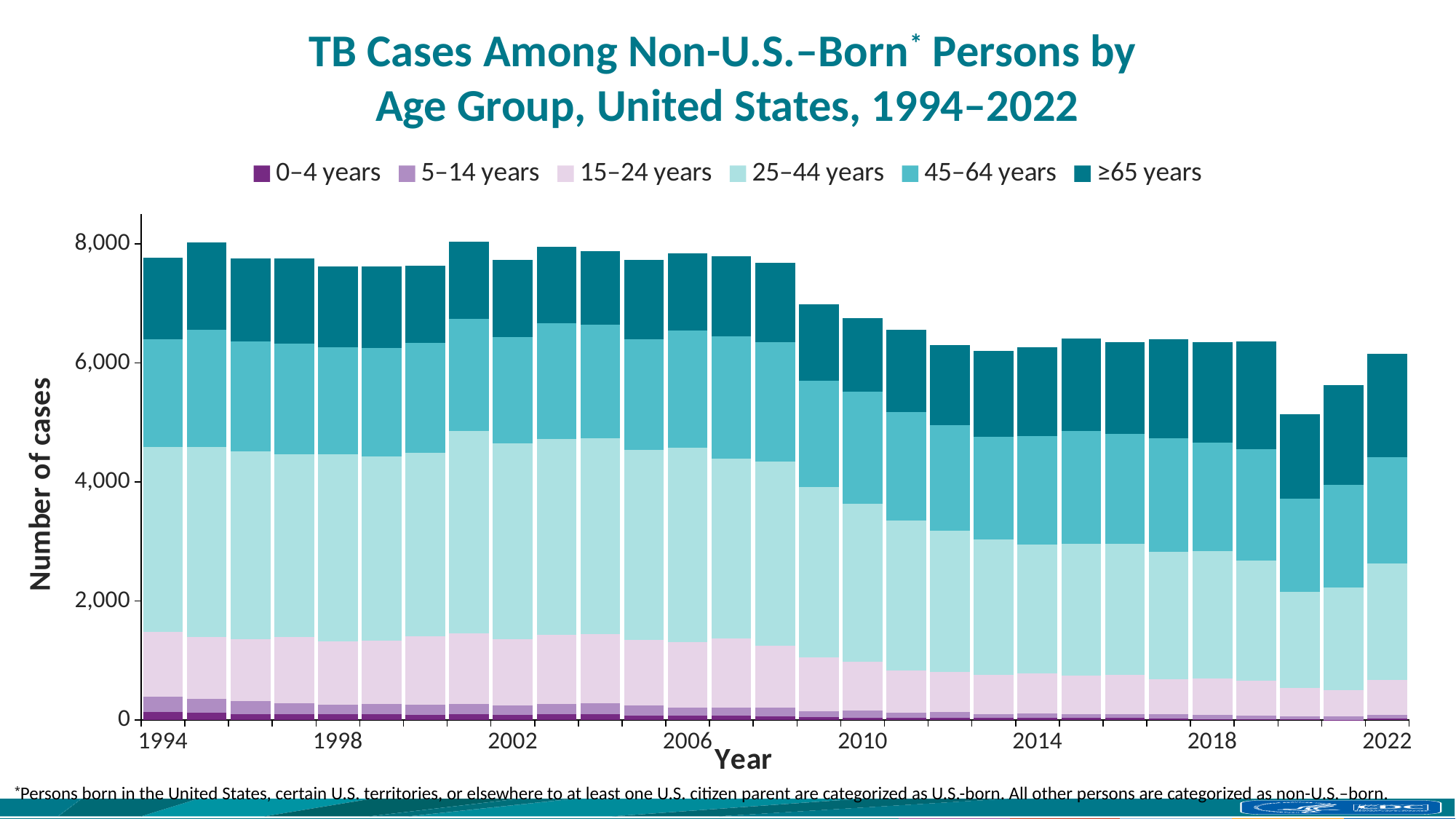
How many years (bars) are plotted on the chart? 29 Which year has a larger total number of cases, 2008 or 2020? 2008 Is the total number of cases for 1994 greater or less than 8,000? less Which age group is shown in the darkest teal at the top of each bar? ≥65 years How many age-group series does the legend list? 6 Which year has the lowest total number of TB cases among non-U.S.-born persons? 2020 Is the total number of cases for 2020 greater or less than 6,000? less What is the label on the y-axis of the chart? Number of cases Is the total number of cases for 2014 greater or less than 8,000? less What kind of chart is shown on the slide? Stacked bar chart Overall, do the total TB case counts rise or fall from 1994 to 2022? fall